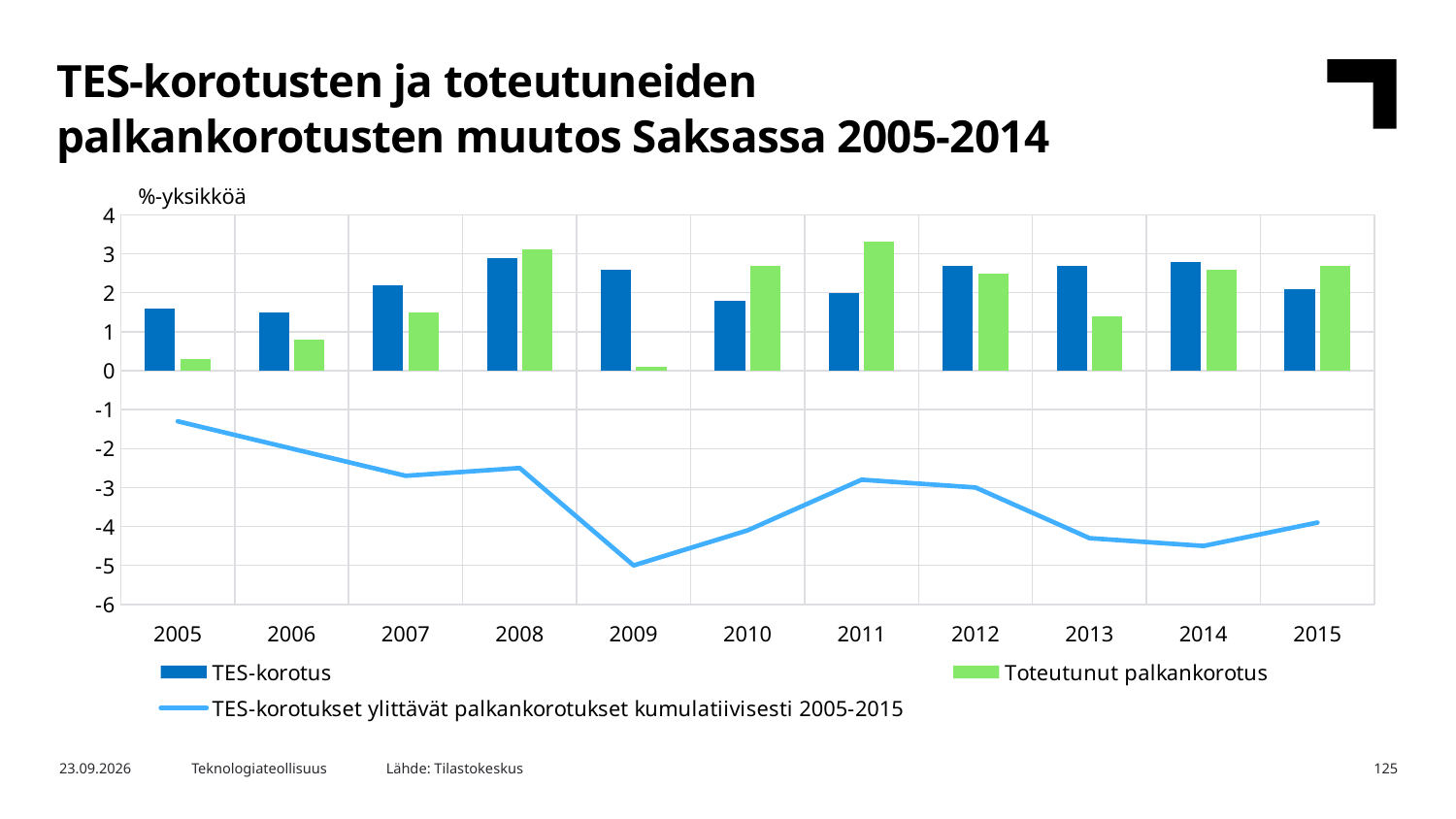
Is the TES-korotus value for 2008 greater or less than 2? greater Is the value of the cumulative line for 2009 greater or less than -4? less Is the Toteutunut palkankorotus value for 2009 greater or less than 1? less In which year is the Toteutunut palkankorotus bar the lowest? 2009 What kind of chart is shown on the slide? A combined bar and line chart How many series does the legend list? 3 In which year is the line 'TES-korotukset ylittävät palkankorotukset kumulatiivisesti 2005-2015' at its highest point? 2005 In 2011, which is larger: TES-korotus or Toteutunut palkankorotus? Toteutunut palkankorotus Does the cumulative line rise or fall from 2005 to 2009? It falls How many years are shown on the x axis? 11 In 2005, which is larger: TES-korotus or Toteutunut palkankorotus? TES-korotus In which year does the line 'TES-korotukset ylittävät palkankorotukset kumulatiivisesti 2005-2015' reach its lowest point? 2009